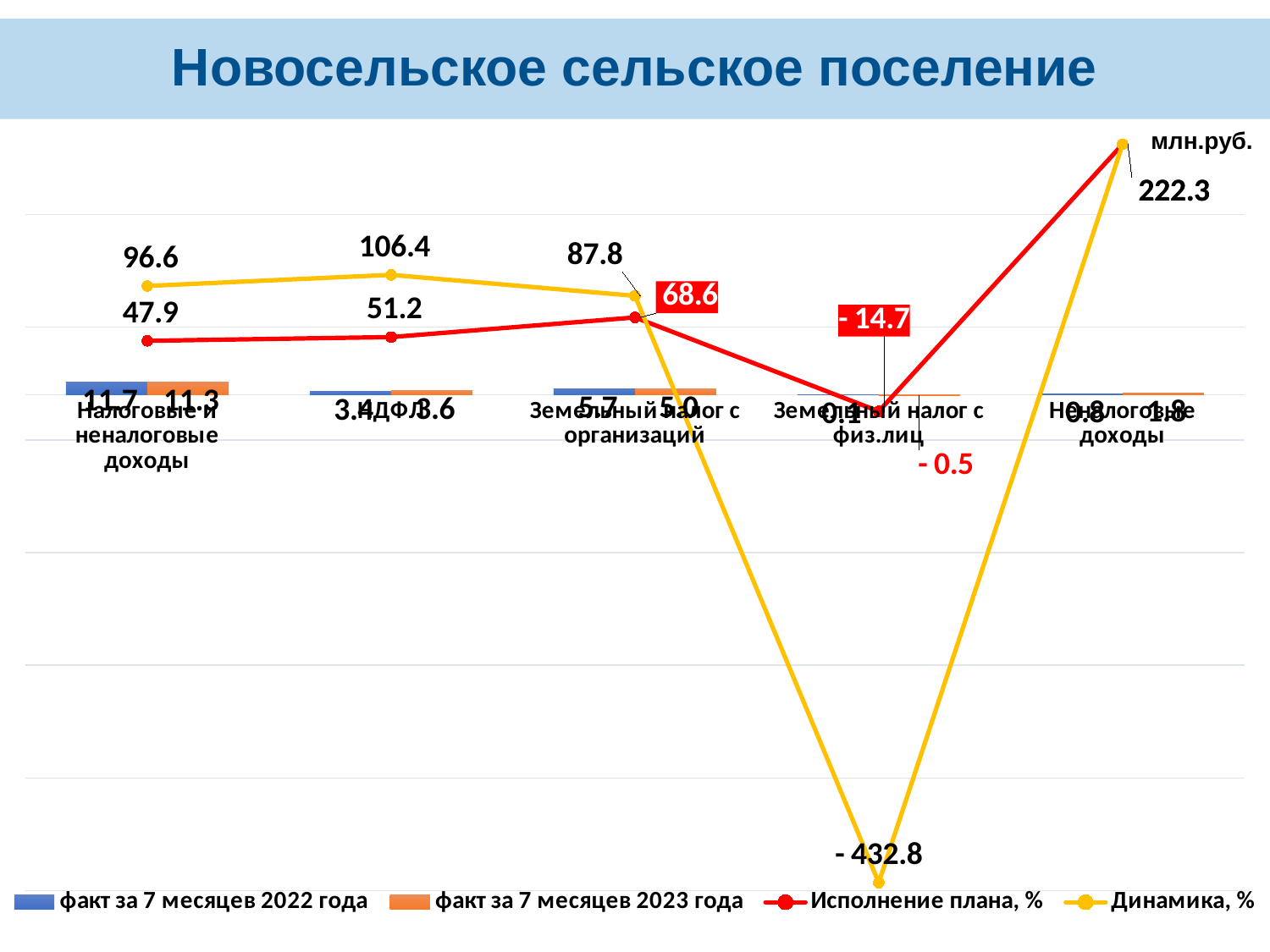
How many categories are shown on the x axis? 5 What is the value of Исполнение плана, % for Налоговые и неналоговые доходы? 47.9 What is the value of Исполнение плана, % for Земельный налог с организаций? 68.6 What is the difference between the Динамика, % values for НДФЛ and Налоговые и неналоговые доходы? 9.8 Which category has the lowest value of Динамика, %? Земельный налог с физ.лиц What is the value of Динамика, % for НДФЛ? 106.4 What is the value of Исполнение плана, % for Земельный налог с физ.лиц? - 14.7 What is the value of Динамика, % for Налоговые и неналоговые доходы? 96.6 How many series does the legend list? 4 What is the value of Динамика, % for Земельный налог с организаций? 87.8 What is the value of Динамика, % for Земельный налог с физ.лиц? - 432.8 What is the value of Исполнение плана, % for НДФЛ? 51.2